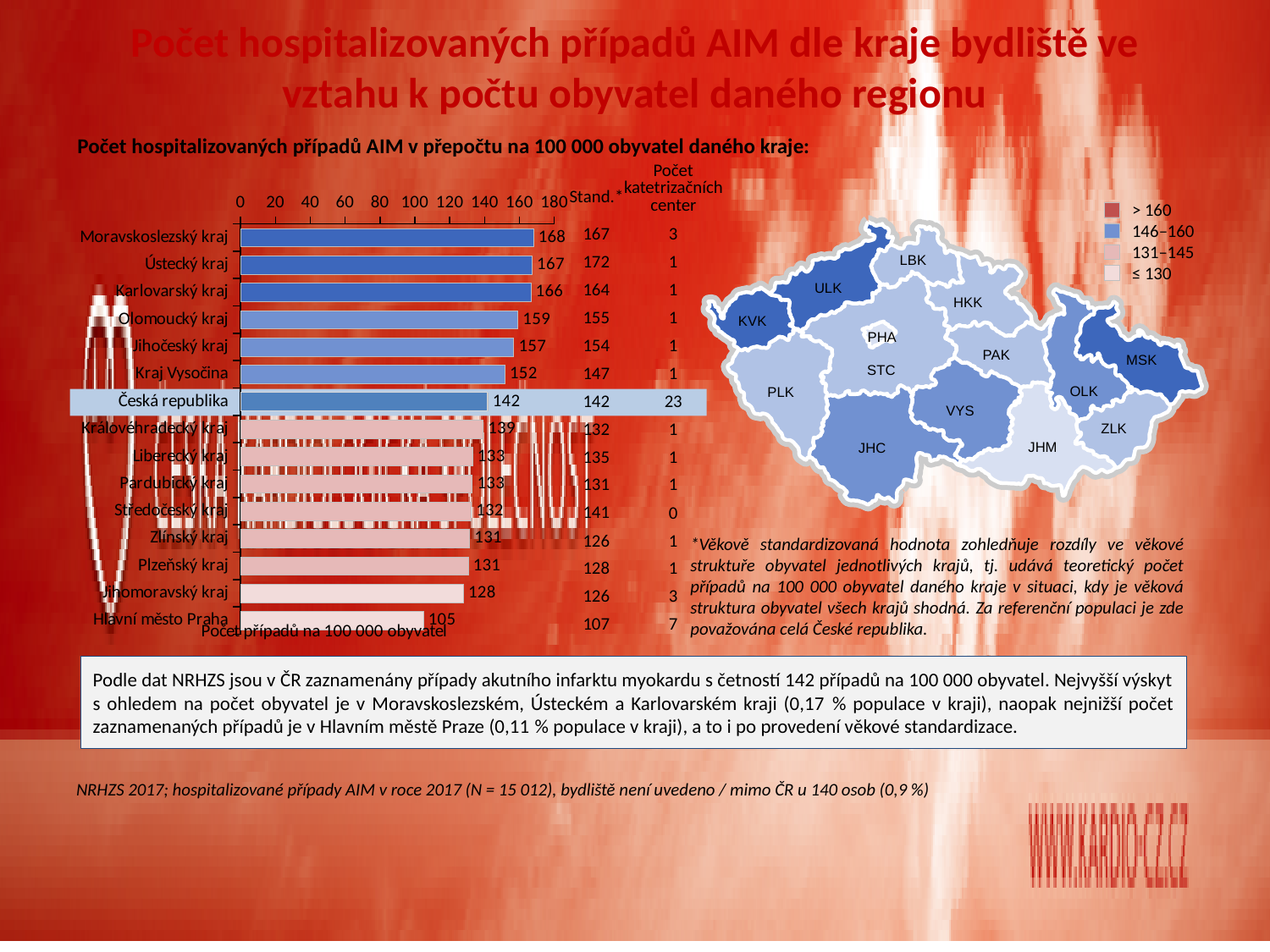
Which region has the highest value in the bar chart? Moravskoslezský kraj What is the value for Kraj Vysočina in the bar chart? 152 What type of chart is used to show the number of hospitalized AIM cases per 100 000 inhabitants by region? Bar chart How many categories (bars) are shown in the bar chart? 15 What is the difference between the values for Moravskoslezský kraj and Hlavní město Praha in the bar chart? 63 What is the difference between the values for Olomoucký kraj and Jihomoravský kraj in the bar chart? 31 Which has a larger value in the bar chart, Jihočeský kraj or Královéhradecký kraj? Jihočeský kraj What is the label of the horizontal axis of the bar chart? Počet případů na 100 000 obyvatel What is the value for Česká republika in the bar chart? 142 What is the value for Hlavní město Praha in the bar chart? 105 Which region has the lowest value in the bar chart? Hlavní město Praha What is the value for Moravskoslezský kraj in the bar chart? 168